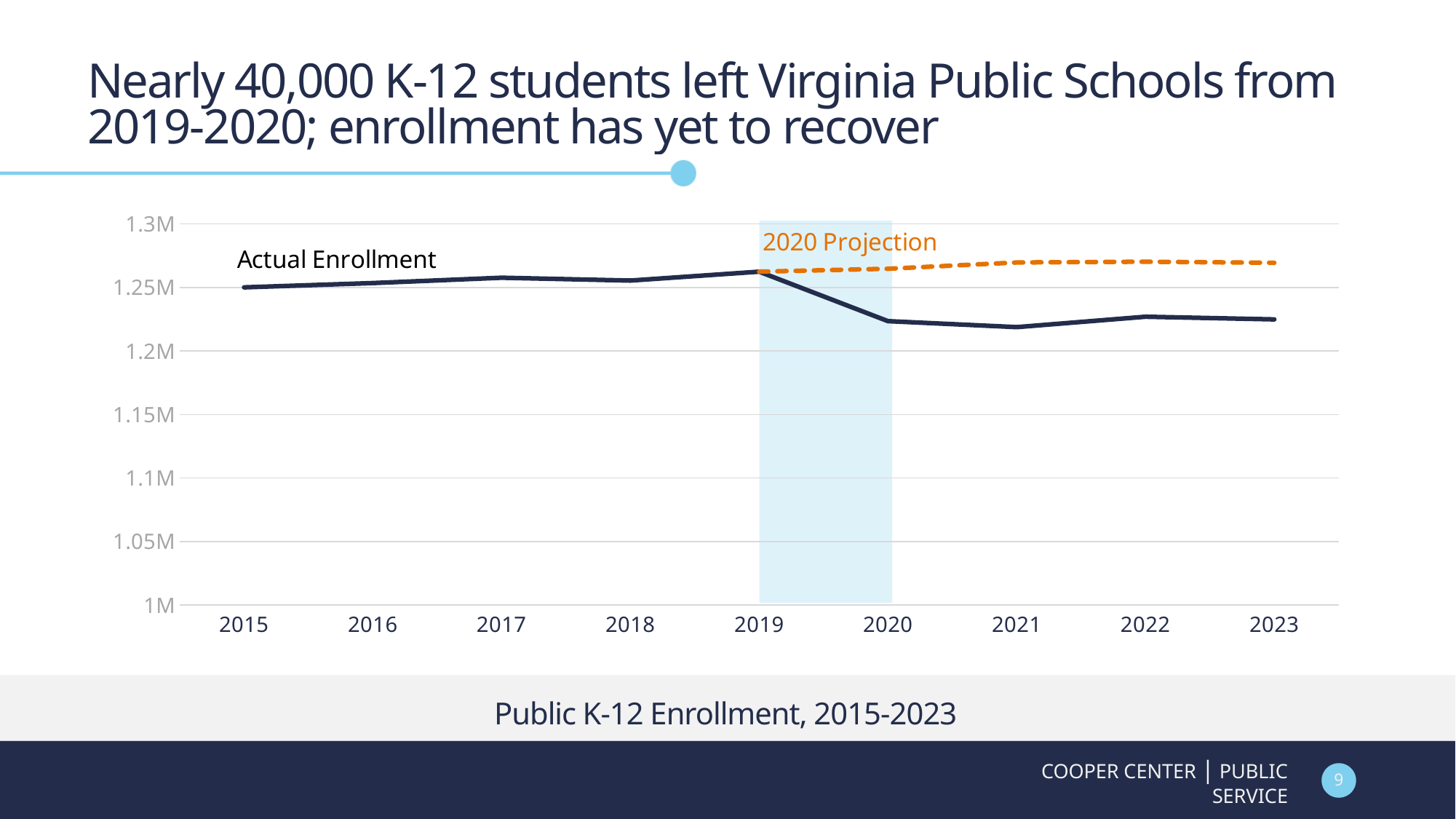
In which year does Actual Enrollment reach its lowest point? 2021 What kind of chart is shown on the slide? line chart Is the Actual Enrollment value for 2020 greater or less than 1.25M? less Is the 2020 Projection value for 2023 greater or less than 1.25M? greater Which is larger in 2023, the Actual Enrollment or the 2020 Projection? 2020 Projection Which series is drawn as an orange dashed line? 2020 Projection What is the title shown beneath the chart? Public K-12 Enrollment, 2015-2023 In which year does Actual Enrollment reach its highest point? 2019 How many years are plotted along the x axis? 9 Does Actual Enrollment rise or fall between 2019 and 2020? fall Is the Actual Enrollment value for 2019 greater or less than 1.25M? greater How many series are plotted on the chart? 2